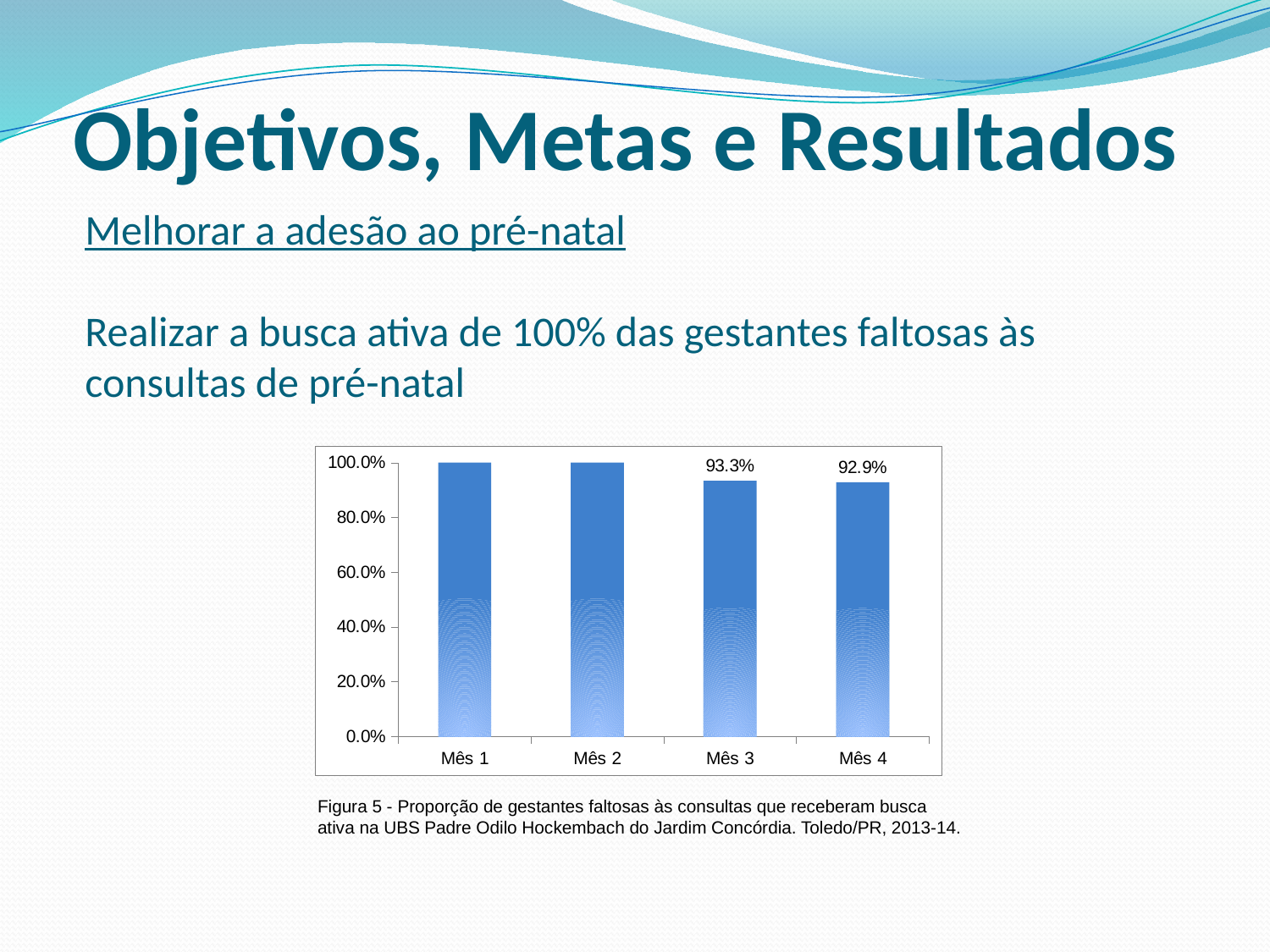
What is the value for Mês 3? 93.3% What is the value for Mês 4? 92.9% What kind of chart is shown on the slide? bar chart What is the difference between the values for Mês 1 and Mês 3? 6.7% How many months are shown on the x axis? 4 What is the value for Mês 1? 100.0% What is the difference between the values for Mês 3 and Mês 4? 0.4% Which is larger, the value for Mês 2 or the value for Mês 3? Mês 2 Which month has the lowest value? Mês 4 Is the value for Mês 4 greater or less than 80.0%? greater Do the values rise or fall from Mês 1 to Mês 4? fall What figure number is given in the caption below the chart? Figura 5